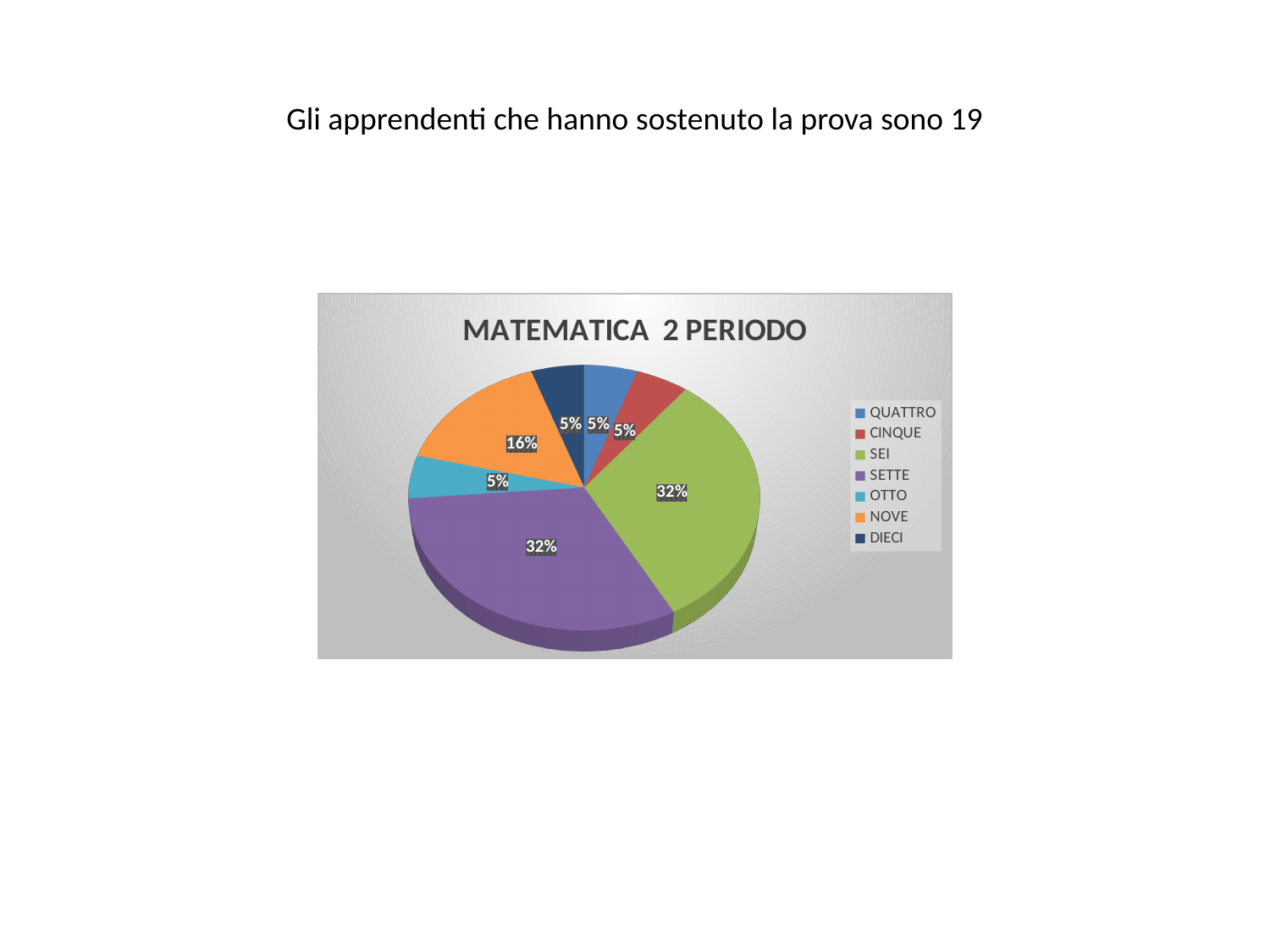
Which is larger, the share for SEI or the share for NOVE? SEI What is the title of the chart? MATEMATICA 2 PERIODO What is the difference between the shares for SETTE and NOVE? 16% Which is larger, the share for NOVE or the share for CINQUE? NOVE What is the value shown for QUATTRO? 5% What is the value shown for DIECI? 5% What share of the pie does SEI represent? 32% What share of the pie does NOVE represent? 16% What is the value shown for SETTE? 32% What is the value shown for OTTO? 5% How many categories does the pie chart show? 7 What kind of chart is shown on the slide? Pie chart